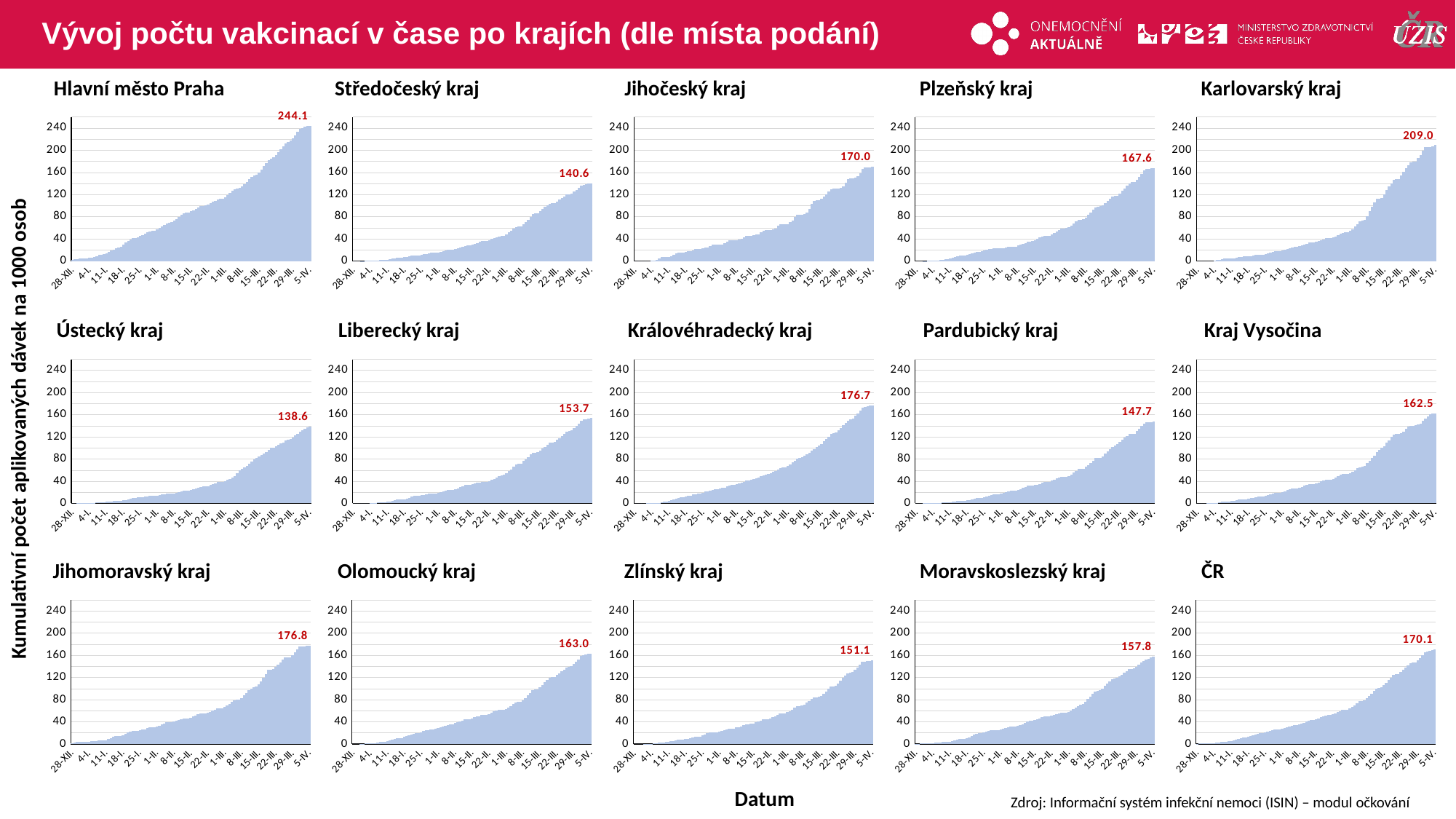
Across all the charts on the slide, which region has the lowest final labelled value? Ústecký kraj Across all the charts on the slide, which region has the highest final labelled value? Hlavní město Praha In the chart titled "Karlovarský kraj", what is the final labelled value? 209.0 In the chart titled "Moravskoslezský kraj", do the values rise or fall along the x axis? rise What kind of chart is used for "Zlínský kraj"? area chart What is the difference between the final labelled values in the "Hlavní město Praha" chart and the "Karlovarský kraj" chart? 35.1 How many charts are shown on the slide? 15 In the chart titled "ČR", what is the final labelled value? 170.1 In the chart titled "Ústecký kraj", what is the final labelled value? 138.6 In the chart titled "Hlavní město Praha", what is the final labelled value? 244.1 In the chart titled "Středočeský kraj", is the value on 1.III. greater or less than 80? less Which has the larger final labelled value: the "Jihomoravský kraj" chart or the "Olomoucký kraj" chart? Jihomoravský kraj